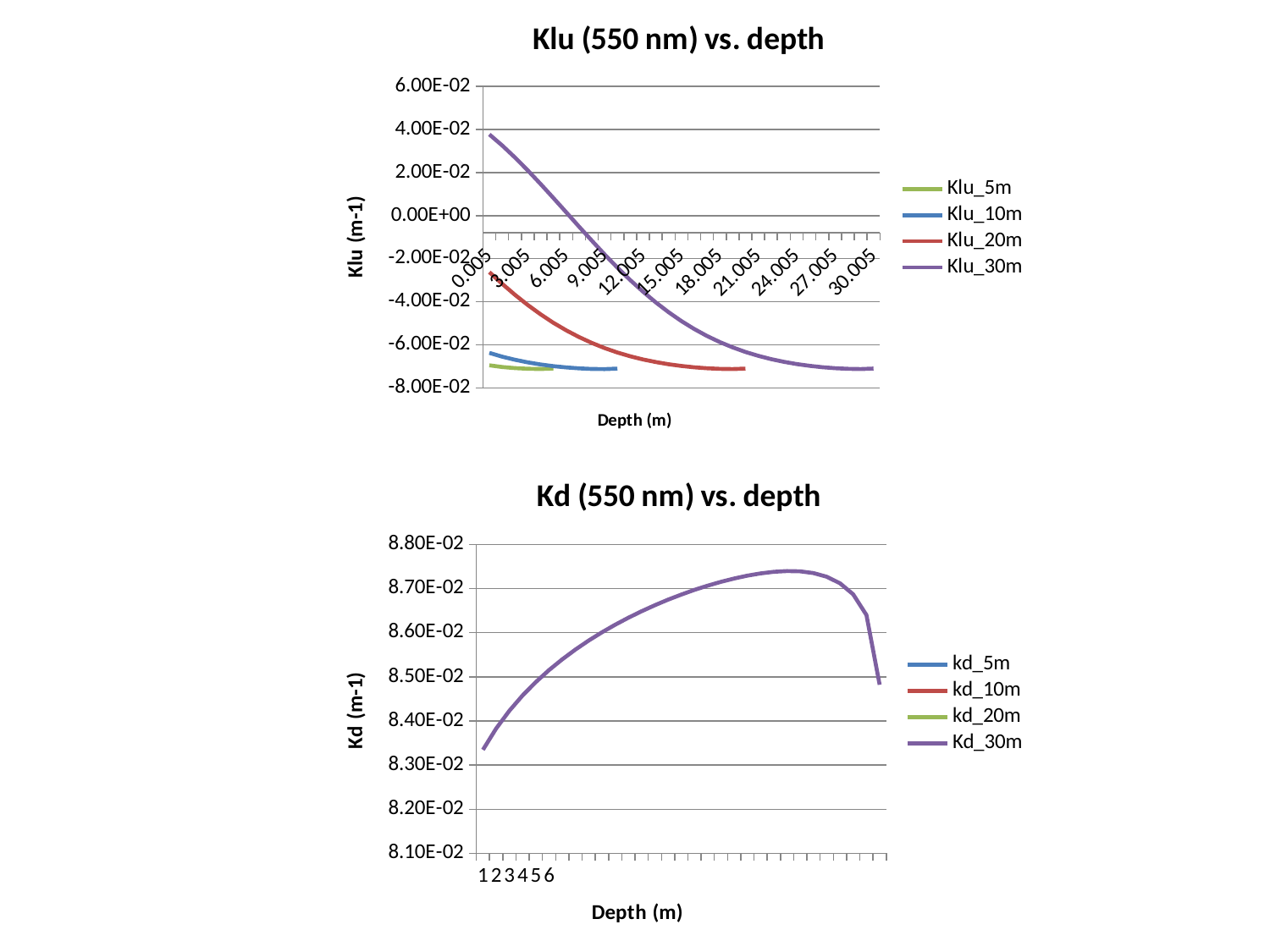
In the 'Klu (550 nm) vs. depth' chart, is the value of Klu_20m at the shallowest depth greater or less than 0.00E+00? less In the 'Klu (550 nm) vs. depth' chart, which series has the highest value at the shallowest depth? Klu_30m In the 'Kd (550 nm) vs. depth' chart, is the peak value of the Kd_30m series greater or less than 8.70E-02? greater What is the y-axis label of the 'Kd (550 nm) vs. depth' chart? Kd (m-1) In the 'Klu (550 nm) vs. depth' chart, which series is plotted in purple? Klu_30m In the 'Klu (550 nm) vs. depth' chart, does the Klu_30m series rise or fall as depth increases? fall What type of chart is the 'Klu (550 nm) vs. depth' chart? line chart How many series does the legend of the 'Kd (550 nm) vs. depth' chart list? 4 In the 'Kd (550 nm) vs. depth' chart, is the value of Kd_30m at the shallowest depth greater or less than 8.40E-02? less In the 'Klu (550 nm) vs. depth' chart, which series extends to the greatest depth along the x axis? Klu_30m How many series does the legend of the 'Klu (550 nm) vs. depth' chart list? 4